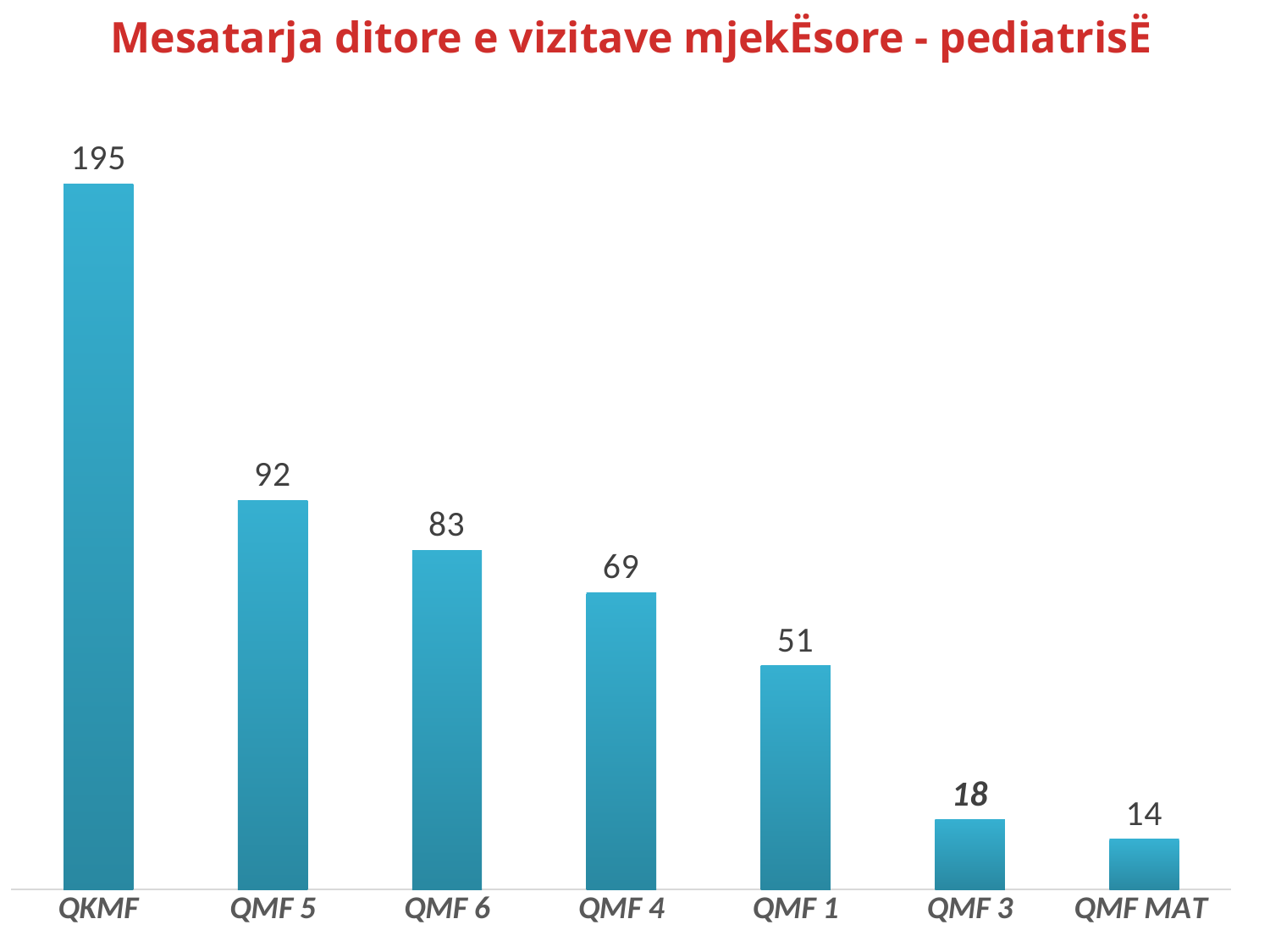
How many categories are shown on the chart? 7 What is the title of the chart? Mesatarja ditore e vizitave mjekËsore - pediatrisË What is the difference between the values for QKMF and QMF 5? 103 What is the difference between the values for QMF 4 and QMF 1? 18 What kind of chart is shown on the slide? Bar chart What is the value for QKMF? 195 Which category has the highest value? QKMF Which category has the lowest value? QMF MAT What is the value for QMF MAT? 14 What is the value for QMF 6? 83 Which is larger, the value for QMF 5 or the value for QMF 6? QMF 5 Do the values rise or fall from left to right along the x axis? Fall